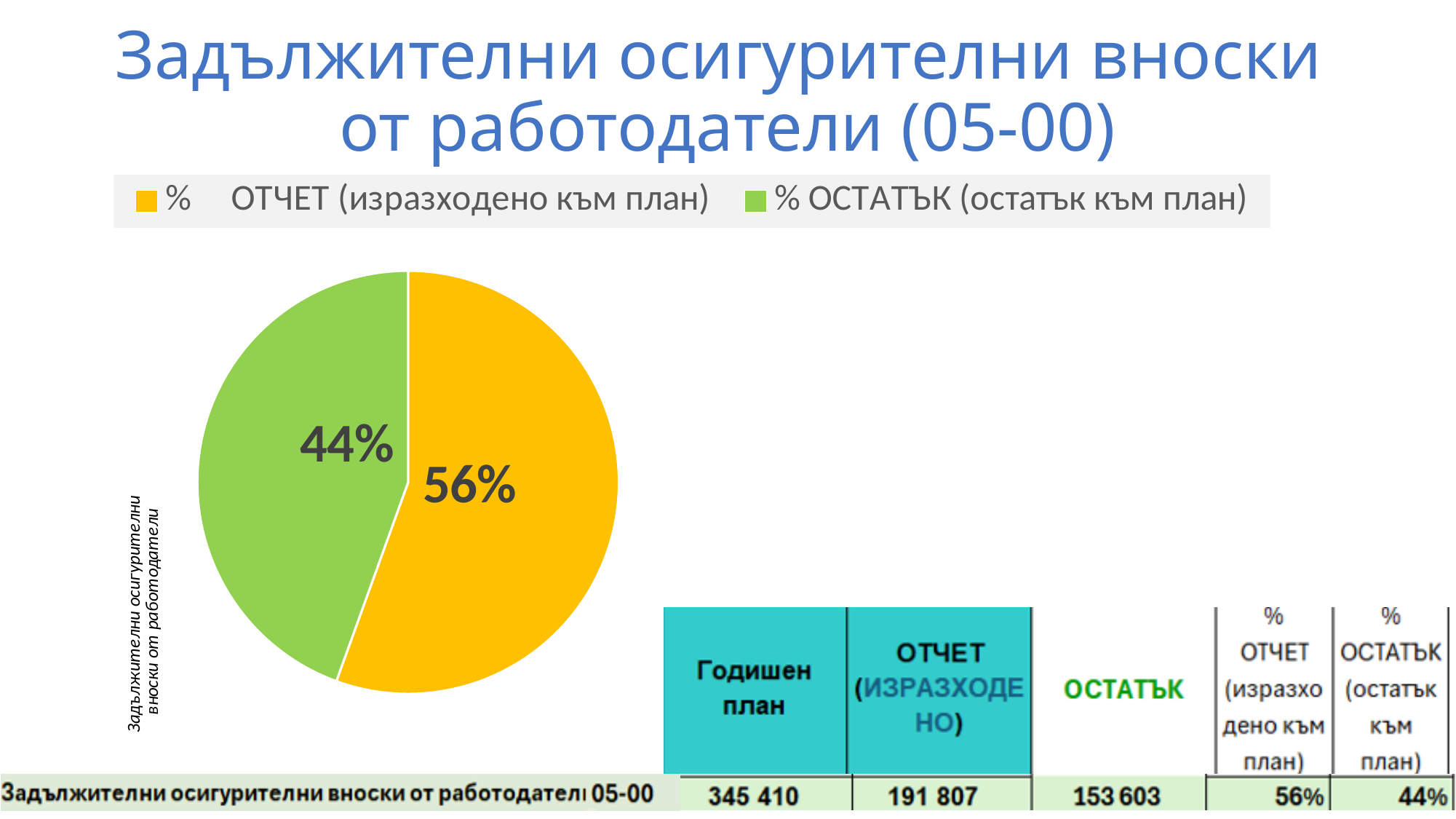
How many entries does the legend list? 2 What kind of chart is shown on the slide? pie chart Is the share of the "% ОТЧЕТ" slice greater or less than 50%? greater What colour is the "% ОСТАТЪК (остатък към план)" slice? green What colour is the "% ОТЧЕТ (изразходено към план)" slice? yellow Which is larger: the "% ОТЧЕТ" slice or the "% ОСТАТЪК" slice? % ОТЧЕТ How many slices does the pie chart have? 2 What share of the pie does the "% ОТЧЕТ (изразходено към план)" slice represent? 56% What share of the pie does the "% ОСТАТЪК (остатък към план)" slice represent? 44% Which slice of the pie is the largest? % ОТЧЕТ (изразходено към план) What is the difference in percentage points between the "% ОТЧЕТ" slice and the "% ОСТАТЪК" slice? 12 percentage points Which slice of the pie is the smallest? % ОСТАТЪК (остатък към план)